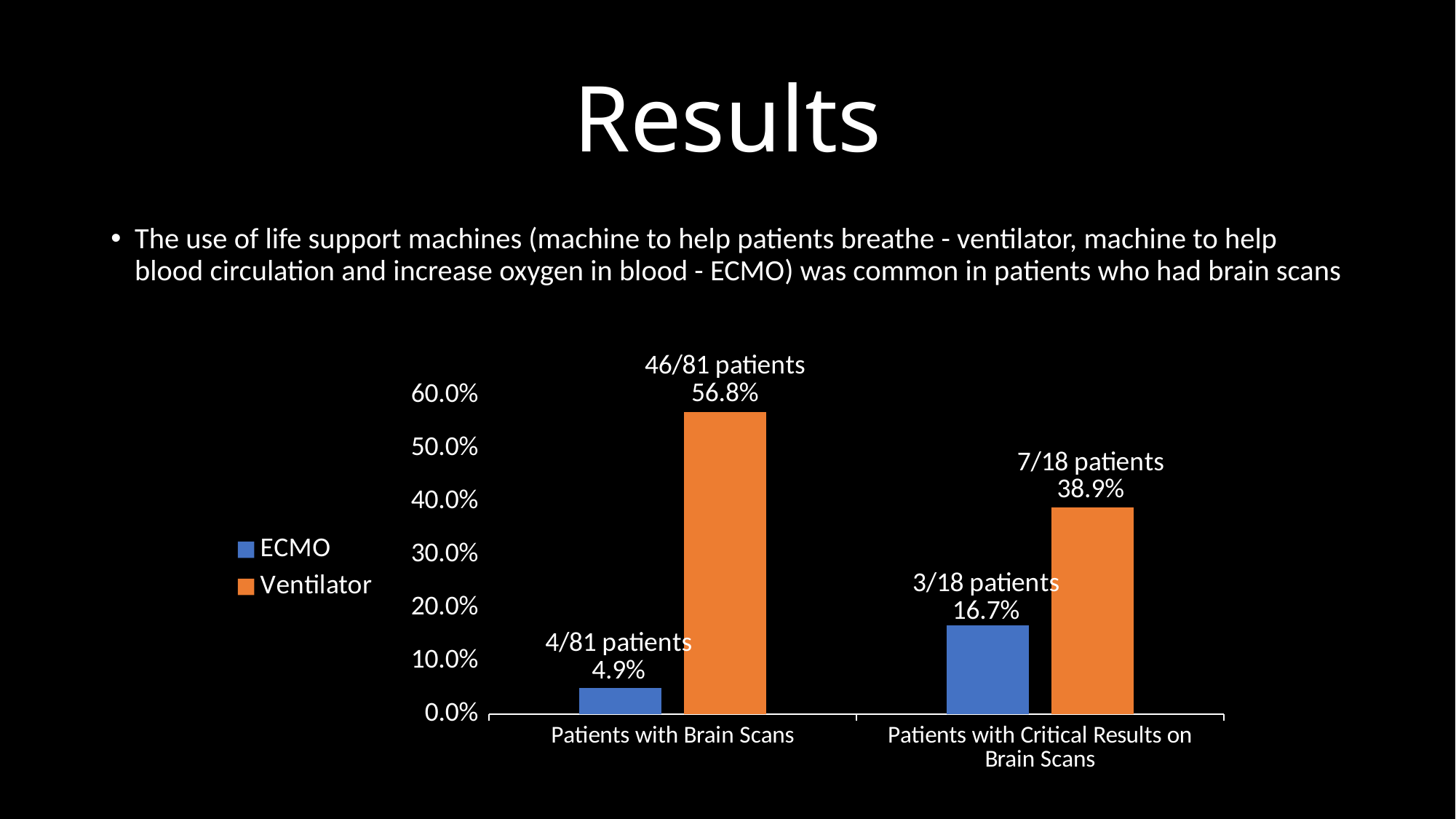
What is the Ventilator value for Patients with Critical Results on Brain Scans? 38.9% What is the Ventilator value for Patients with Brain Scans? 56.8% Which is larger for Patients with Brain Scans, the ECMO value or the Ventilator value? Ventilator Which bar has the highest value in the chart? Ventilator, Patients with Brain Scans What kind of chart is shown on the slide? Bar chart What is the ECMO value for Patients with Critical Results on Brain Scans? 16.7% Which bar has the lowest value in the chart? ECMO, Patients with Brain Scans How many series does the legend list? 2 What is the ECMO value for Patients with Brain Scans? 4.9% What is the difference between the Ventilator and ECMO values for Patients with Critical Results on Brain Scans? 22.2% How many patients does the Ventilator bar for Patients with Brain Scans represent? 46/81 patients What colour represents the Ventilator series in the chart? Orange